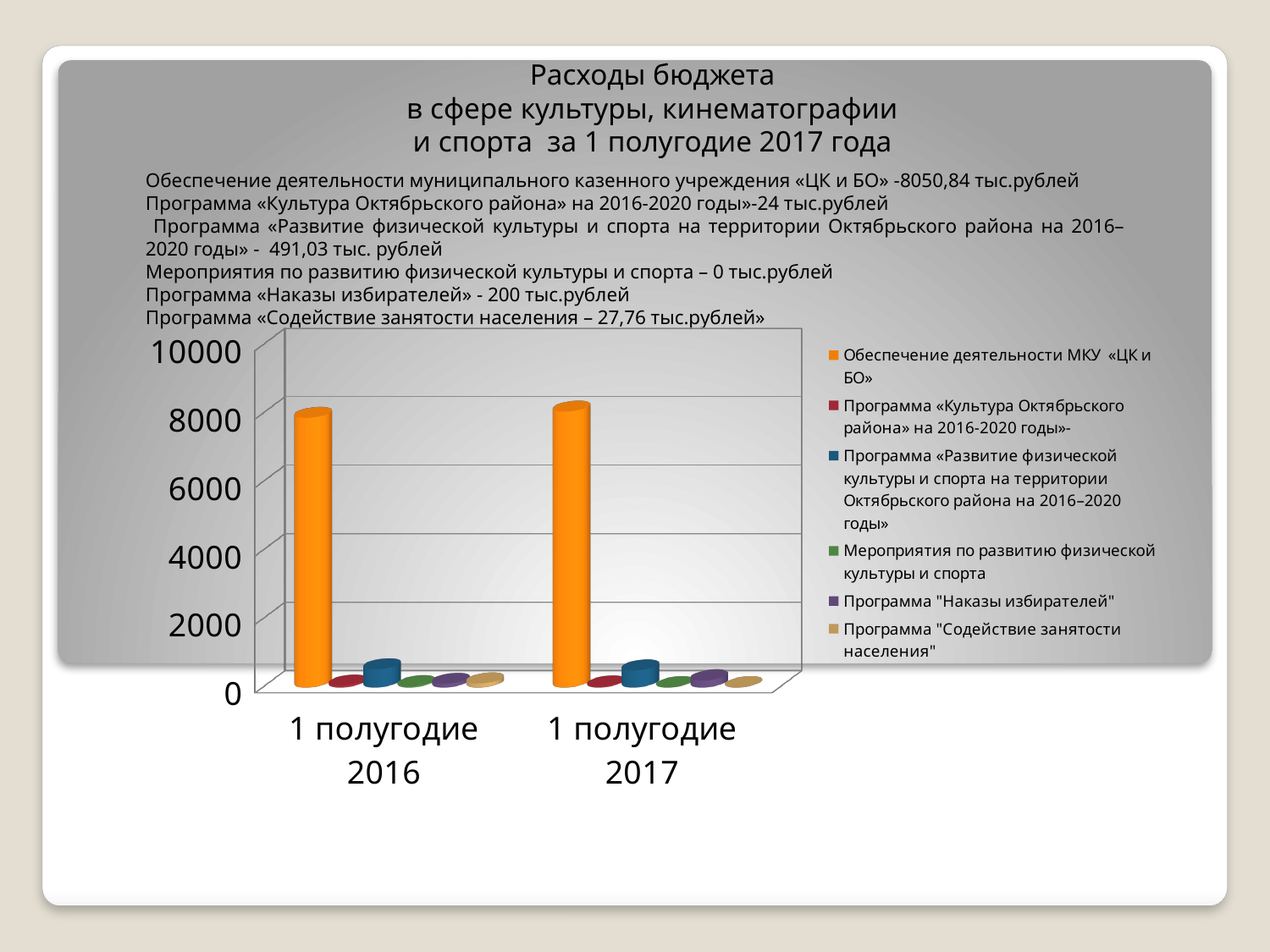
Which colour represents Обеспечение деятельности МКУ «ЦК и БО» in the chart legend? orange Which series has the highest value for 1 полугодие 2016? Обеспечение деятельности МКУ «ЦК и БО» How many categories are shown on the x axis of the chart? 2 Is the value for Обеспечение деятельности МКУ «ЦК и БО» in 1 полугодие 2017 greater or less than 6000? greater How many series does the chart legend list? 6 Is the value for Программа «Развитие физической культуры и спорта на территории Октябрьского района на 2016–2020 годы» in 1 полугодие 2017 greater or less than 2000? less What is the highest value shown on the vertical axis of the chart? 10000 In 1 полугодие 2016, which is larger: Программа «Развитие физической культуры и спорта на территории Октябрьского района на 2016–2020 годы» or Программа «Культура Октябрьского района» на 2016-2020 годы»? Программа «Развитие физической культуры и спорта на территории Октябрьского района на 2016–2020 годы» Is the value for Обеспечение деятельности МКУ «ЦК и БО» in 1 полугодие 2016 greater or less than 6000? greater What kind of chart is shown on the slide? bar chart In 1 полугодие 2017, which is larger: Обеспечение деятельности МКУ «ЦК и БО» or Программа «Культура Октябрьского района» на 2016-2020 годы»? Обеспечение деятельности МКУ «ЦК и БО» Which series has the highest value for 1 полугодие 2017? Обеспечение деятельности МКУ «ЦК и БО»